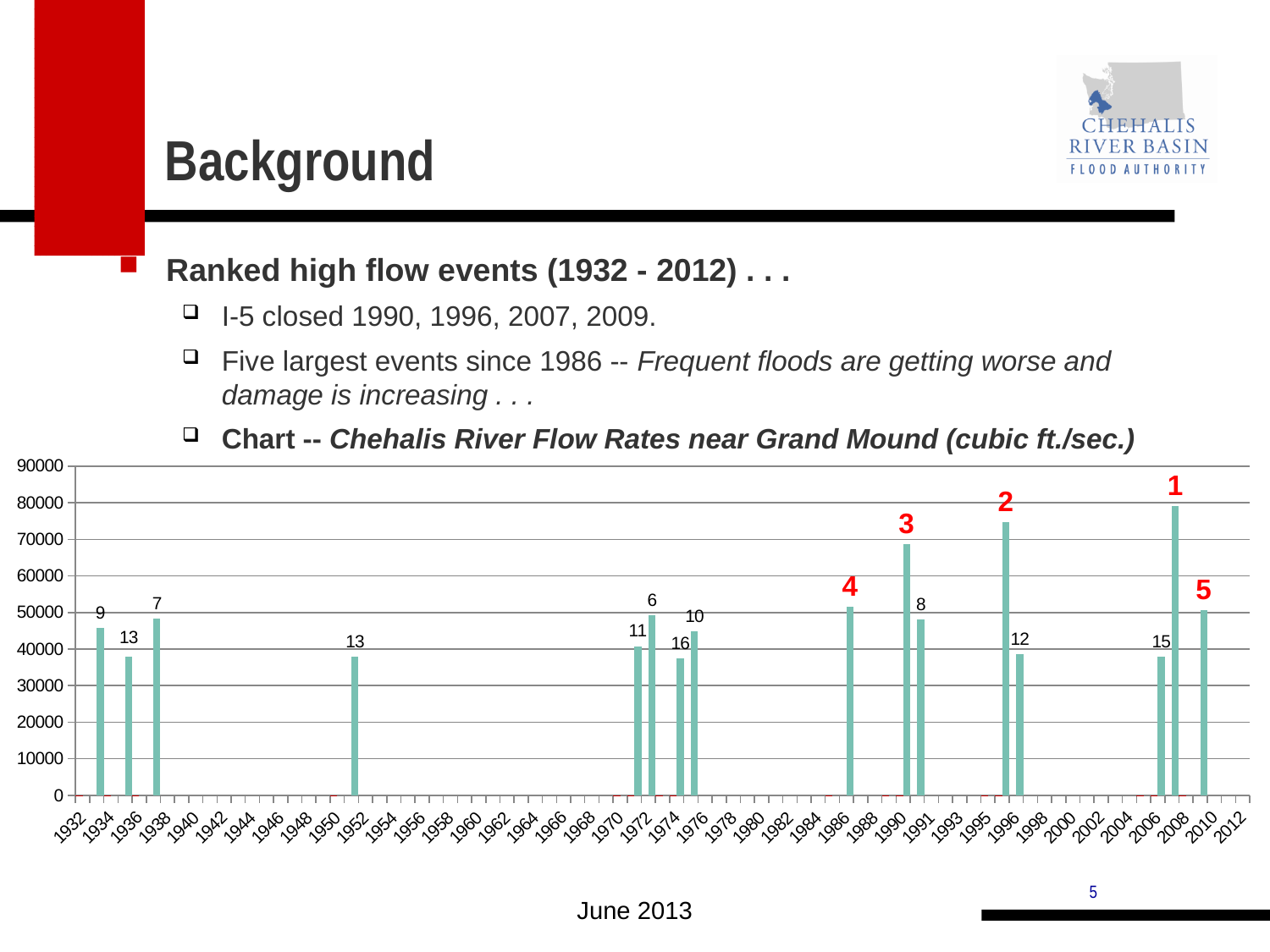
Is the value of the bar labeled 6 greater or less than 40000? greater Is the value of the bar labeled 1 greater or less than 70000? greater How many bars (high flow events) are plotted in the chart? 16 How many bars in the chart have their rank label printed in red? 5 Which is larger, the bar labeled 3 or the bar labeled 4? the bar labeled 3 Is the value of the bar labeled 2 greater or less than 70000? greater What kind of chart is shown on the slide? bar chart Which rank label marks the tallest bar in the chart? 1 What is the title of the chart on the slide? Chehalis River Flow Rates near Grand Mound (cubic ft./sec.)